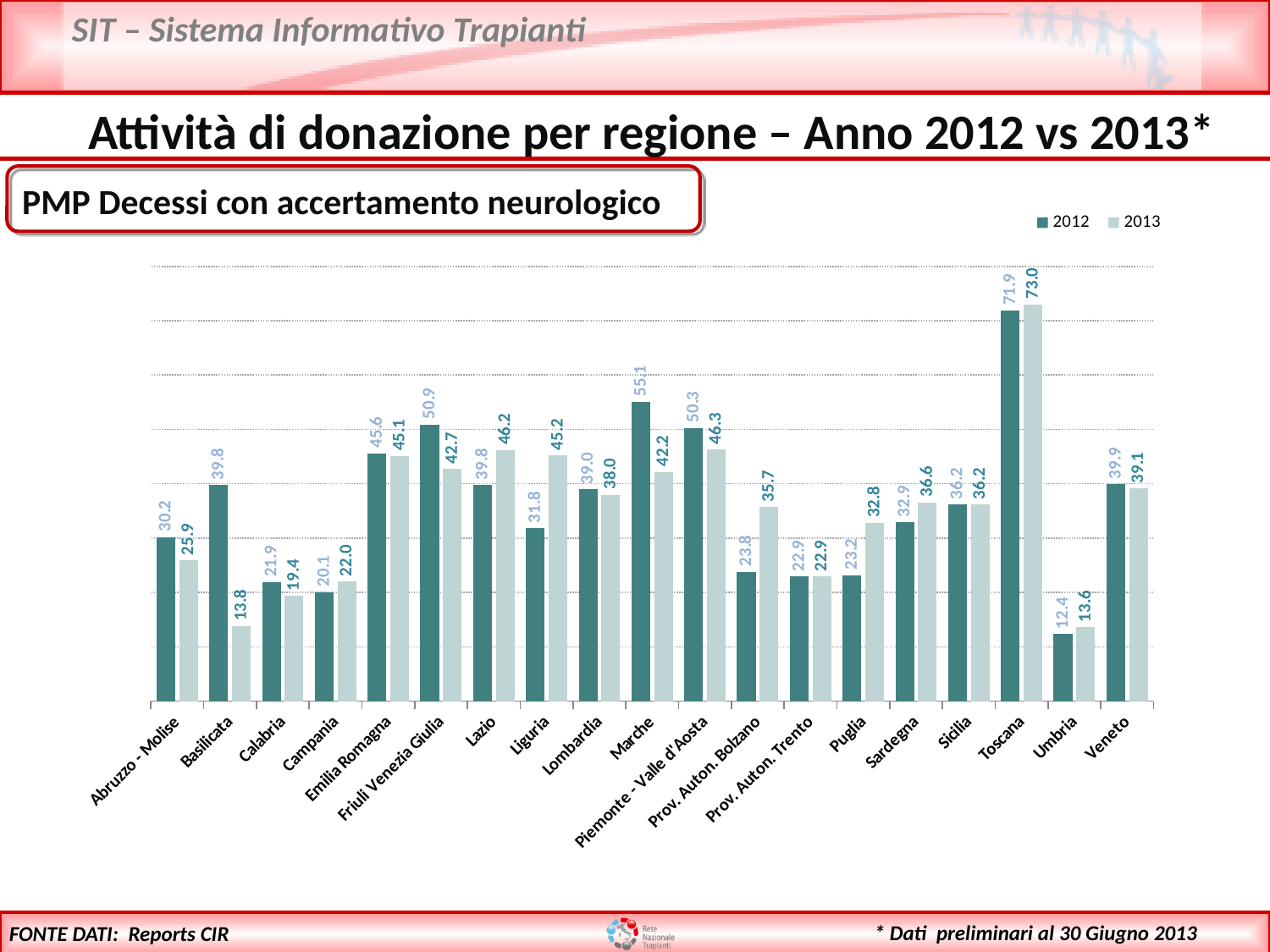
How many series does the legend list? 2 Which region has the highest 2013 value? Toscana What is the 2012 value for Toscana? 71.9 Which is larger, the 2012 value for Friuli Venezia Giulia or the 2012 value for Piemonte - Valle d'Aosta? Friuli Venezia Giulia Which region has the lowest 2012 value? Umbria What is the difference between the 2013 values for Lazio and Lombardia? 8.2 What is the 2013 value for Prov. Auton. Bolzano? 35.7 What is the difference between the 2012 and 2013 values for Marche? 12.9 How many regions are shown on the x axis? 19 What kind of chart is shown on the slide? Bar chart Which is larger for Liguria, the 2012 value or the 2013 value? 2013 What is the 2013 value for Basilicata? 13.8